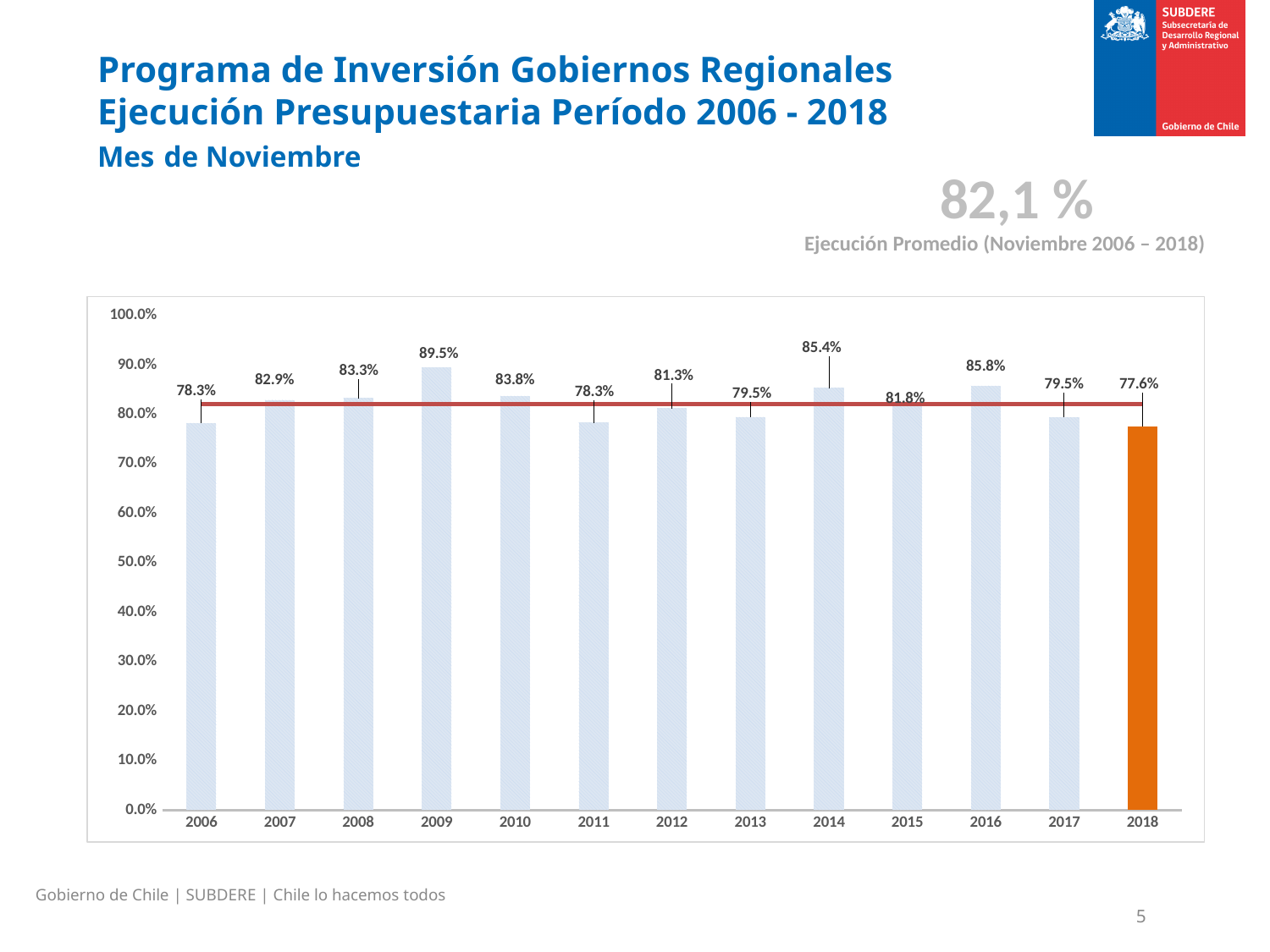
Which year has the lowest value? 2018 What kind of chart is shown? bar chart Which year has the highest value? 2009 Which year's bar is coloured orange? 2018 What average execution value is shown above the chart? 82,1 % Is the value for 2011 greater or less than 80.0%? less What is the difference between the values for 2009 and 2018? 11.9% What is the value for 2018? 77.6% What is the value for 2009? 89.5% Which is larger, the value for 2016 or the value for 2017? 2016 What is the value for 2014? 85.4% How many years are shown on the x axis? 13